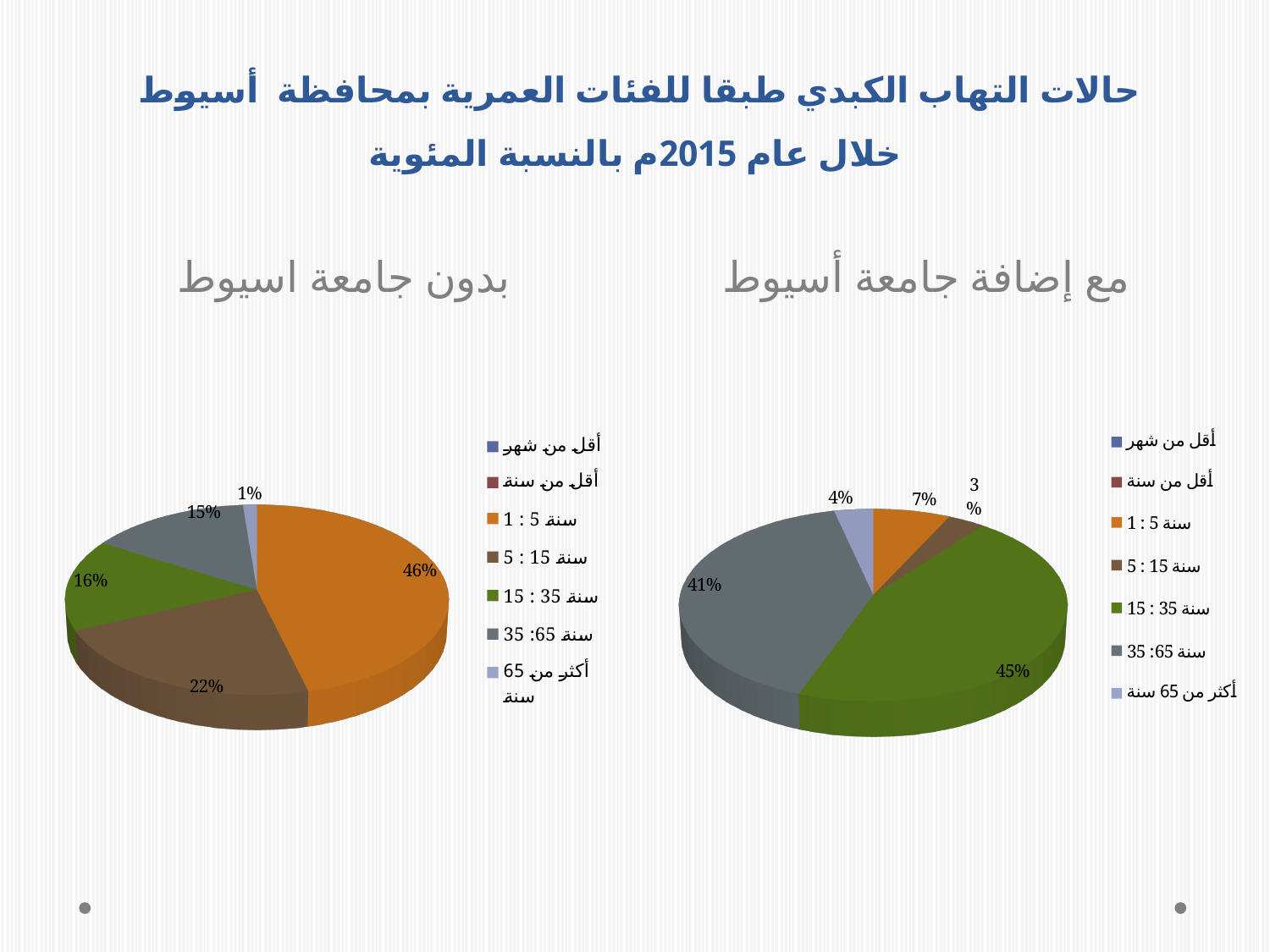
In the chart titled "مع إضافة جامعة أسيوط", what is the share for the 35 :65 سنة category? 41% In the chart titled "مع إضافة جامعة أسيوط", which category has the largest share? 15 : 35 سنة In the chart titled "بدون جامعة اسيوط", which is larger: the share for 15 : 35 سنة or the share for 5 : 15 سنة? 5 : 15 سنة In the chart titled "بدون جامعة اسيوط", which category has the largest share? 1 : 5 سنة What kind of charts are shown on the slide? Pie charts In the chart titled "بدون جامعة اسيوط", what is the share for the 1 : 5 سنة category? 46% In the chart titled "بدون جامعة اسيوط", what is the share for the 5 : 15 سنة category? 22% In the chart titled "مع إضافة جامعة أسيوط", what is the share for the 15 : 35 سنة category? 45% In the chart titled "مع إضافة جامعة أسيوط", what is the share for the 1 : 5 سنة category? 7% In the chart titled "مع إضافة جامعة أسيوط", what is the difference between the shares of 15 : 35 سنة and 35 :65 سنة? 4% In the chart titled "بدون جامعة اسيوط", what is the share for the أكثر من 65 سنة category? 1% How many entries does the legend of the chart titled "بدون جامعة اسيوط" list? 7